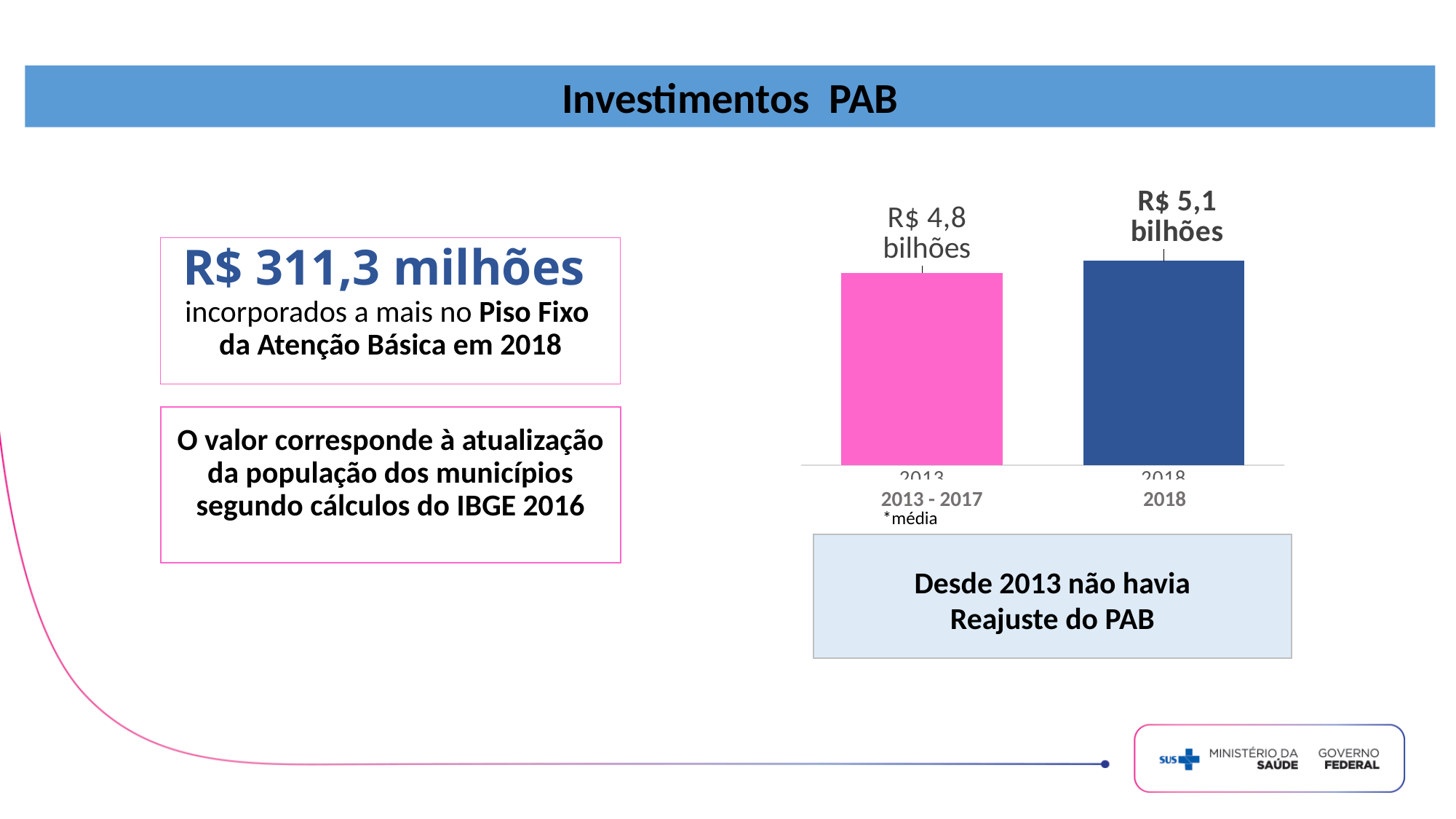
Which is larger, the value for 2013 - 2017 or the value for 2018? 2018 What is the title of the slide containing the chart? Investimentos PAB Which category has the highest value? 2018 What kind of chart is shown on the slide? Bar chart Which category has the lowest value? 2013 - 2017 How many bars are plotted in the chart? 2 What is the difference between the 2018 value and the 2013 - 2017 value? R$ 0,3 bilhões What value is shown for the 2013 - 2017 bar? R$ 4,8 bilhões What value is shown for the 2018 bar? R$ 5,1 bilhões Do the values rise or fall from the 2013 - 2017 bar to the 2018 bar? Rise What colour is the 2013 - 2017 bar? Pink